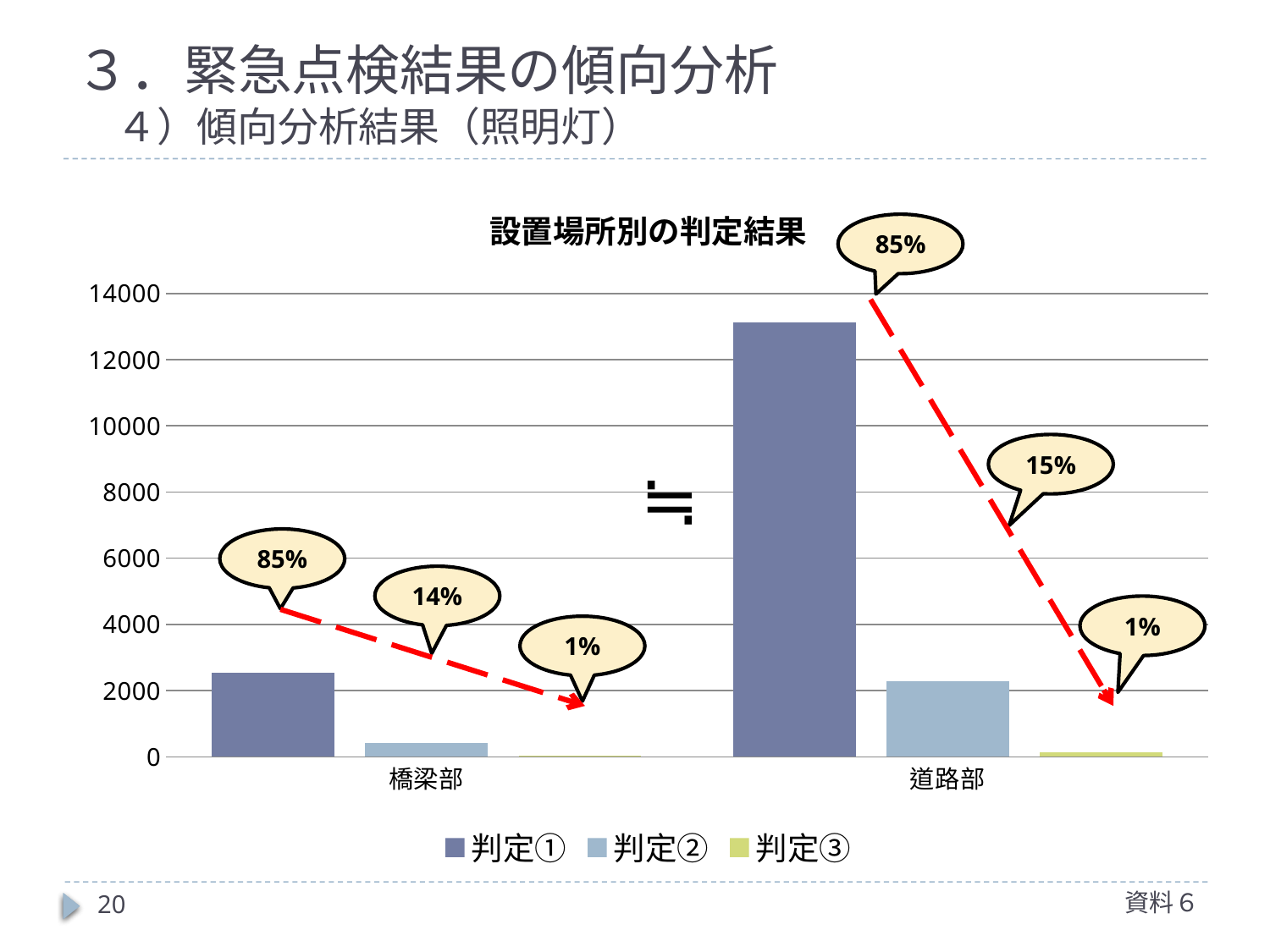
What percentage does the callout above the 判定② bar for 橋梁部 show? 14% Is the value of 判定② for 道路部 greater or less than 2000? greater Is the value of 判定① for 道路部 greater or less than 12000? greater Which is larger, 判定② for 橋梁部 or 判定② for 道路部? 道路部 How many series does the legend list? 3 How many categories are shown on the x axis? 2 Which category has the highest 判定① bar? 道路部 Which series has the lowest bar for 道路部? 判定③ What type of chart is shown on the slide? bar chart Is the value of 判定① for 橋梁部 greater or less than 2000? greater What is the title of the chart? 設置場所別の判定結果